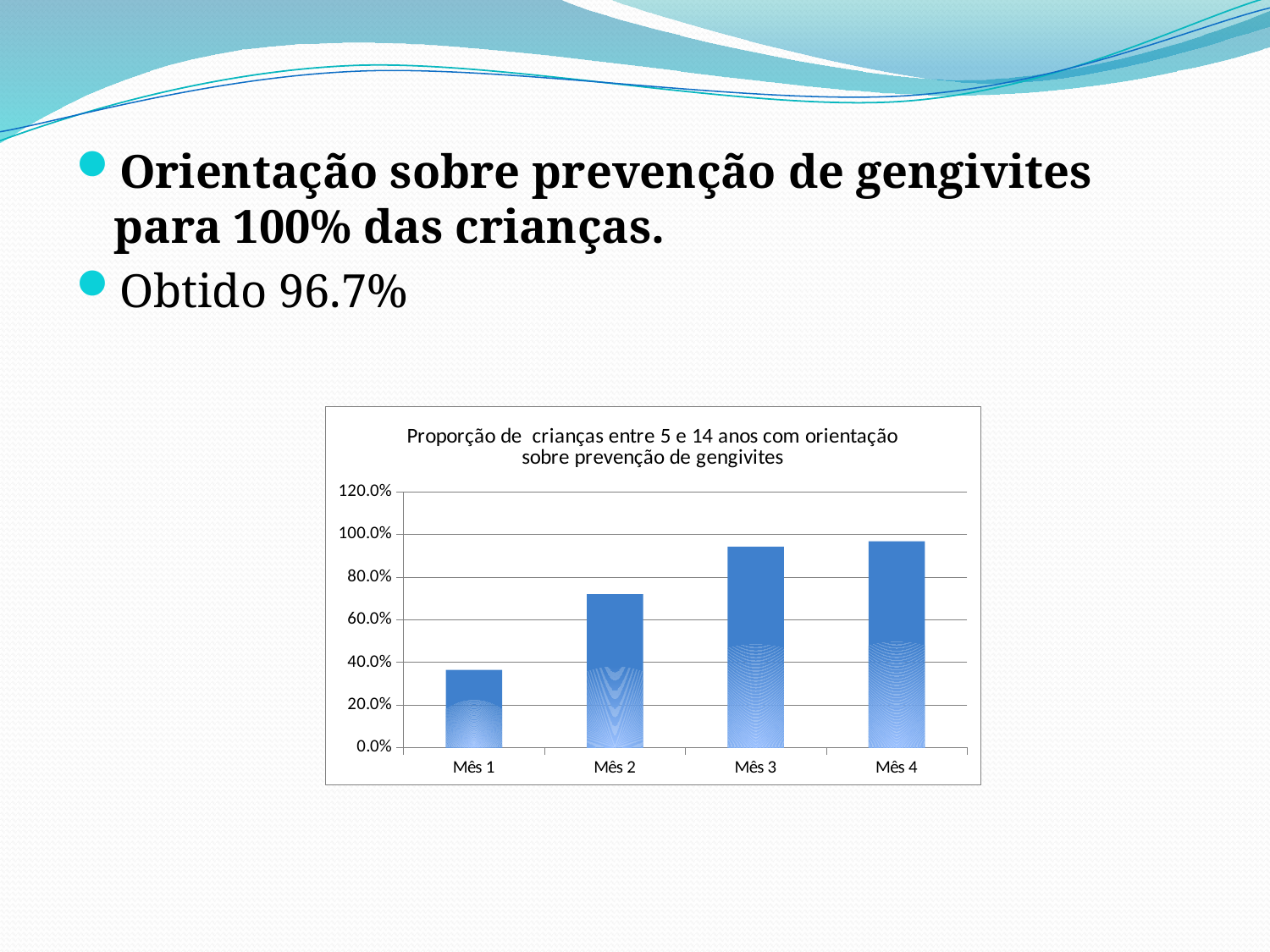
Which month has the lowest proportion of children with orientation on gingivitis prevention? Mês 1 Is the value for Mês 1 greater or less than 40.0%? less Is the value for Mês 2 greater or less than 60.0%? greater Which is larger, the value for Mês 3 or the value for Mês 2? Mês 3 Is the value for Mês 3 greater or less than 80.0%? greater What is the highest value shown on the vertical axis of the chart? 120.0% How many categories (months) are plotted on the chart? 4 Do the values rise or fall from Mês 1 to Mês 4? rise What kind of chart is shown on the slide? bar chart Which is larger, the value for Mês 2 or the value for Mês 1? Mês 2 What is the title of the chart? Proporção de crianças entre 5 e 14 anos com orientação sobre prevenção de gengivites